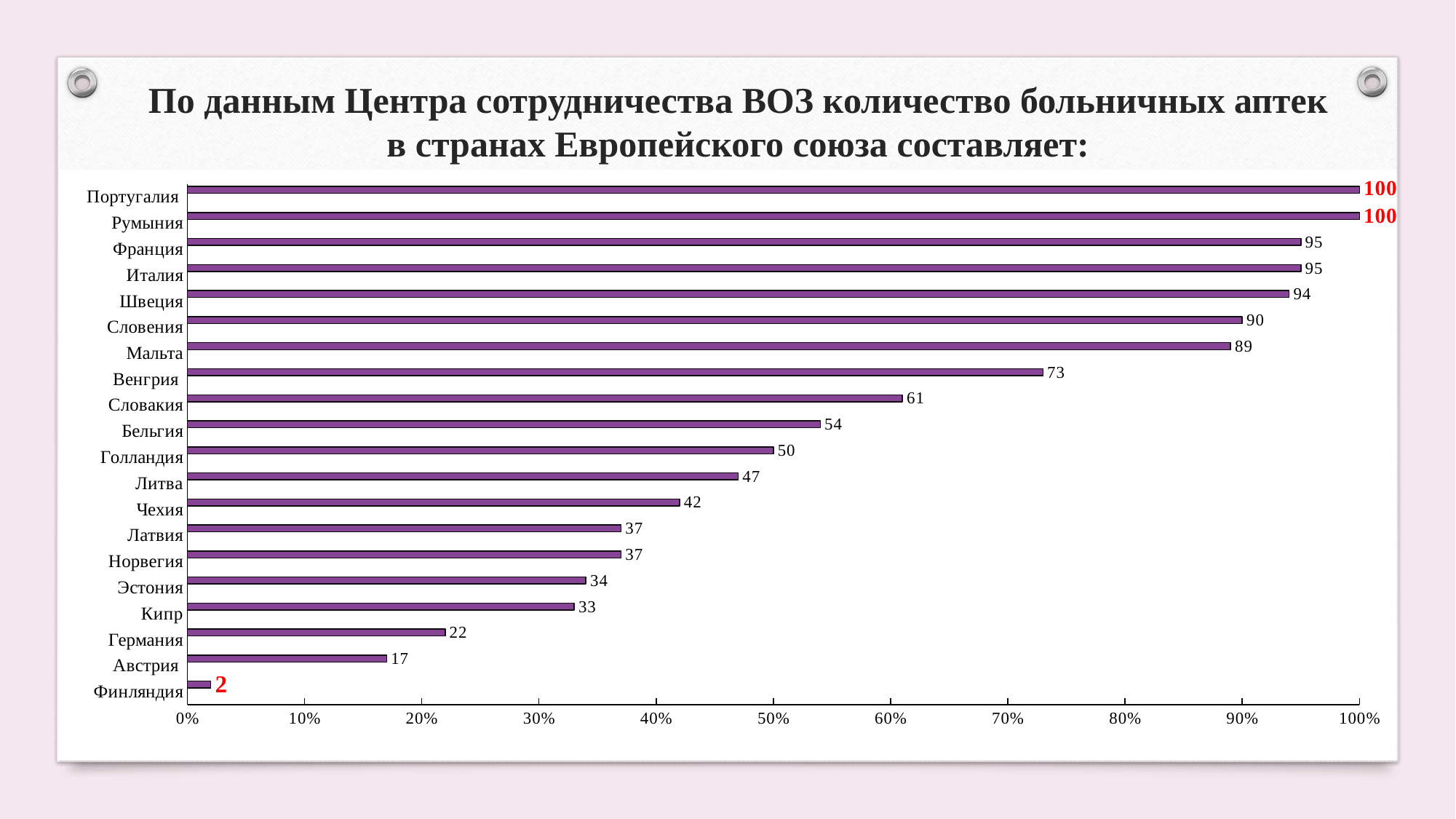
Which country has the lowest value on the chart? Финляндия What is the highest tick label on the horizontal axis? 100% Is the value for Швеция greater or less than 90%? greater What is the value shown for Венгрия? 73 What is the difference between the values for Австрия and Финляндия? 15 What kind of chart is shown on the slide? bar chart How many countries are shown on the chart? 20 Which two countries share the highest value of 100? Португалия and Румыния Which has a larger value, Литва or Чехия? Литва What is the value shown for Словакия? 61 What is the value shown for Германия? 22 What is the difference between the values for Мальта and Бельгия? 35